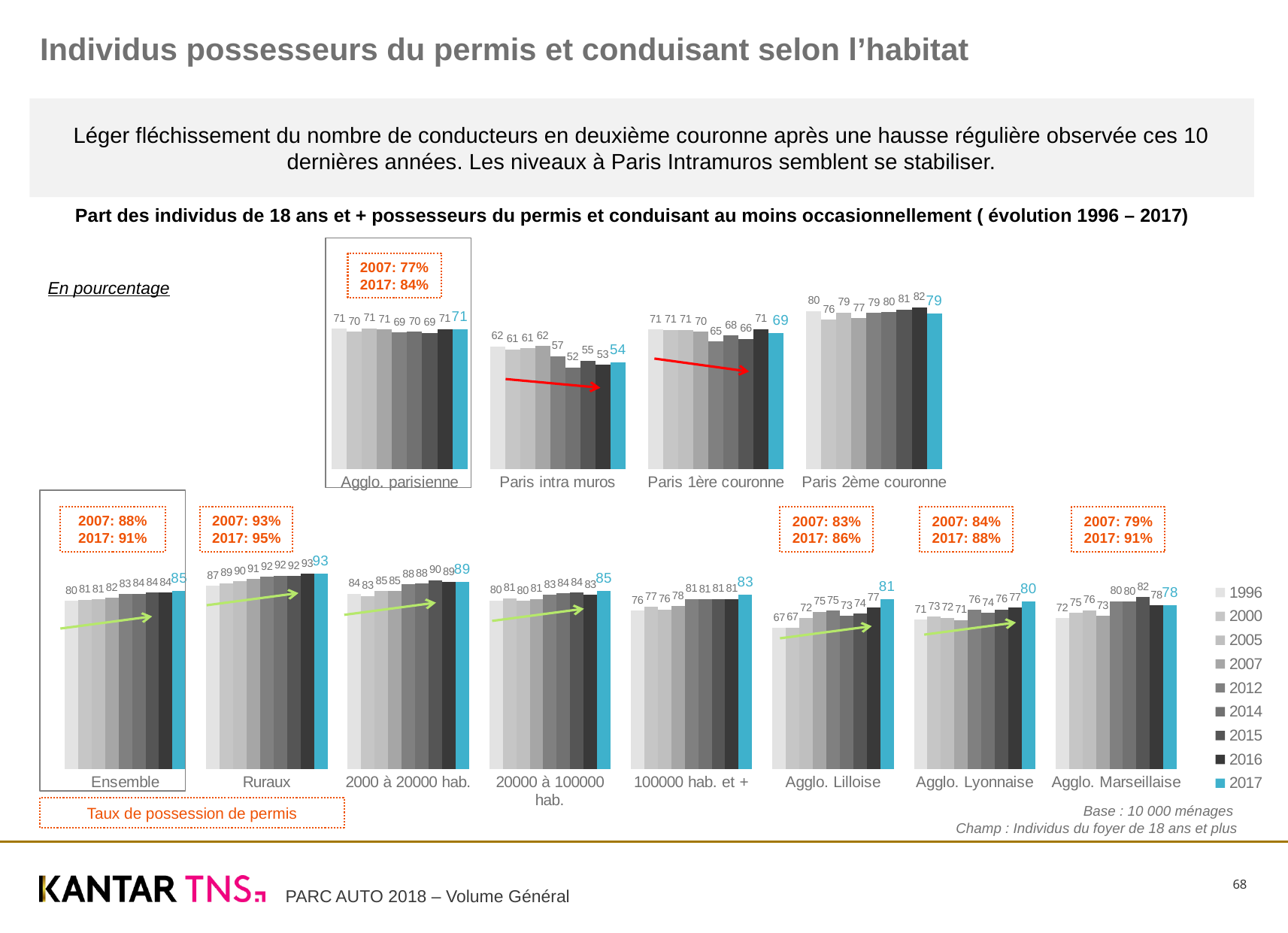
What is the 1996 value for Agglo. Lilloise? 67 What kind of chart is shown on the slide? Bar chart What is the 2017 value for Ruraux? 93 Which category has the highest 2017 value? Ruraux How many series does the legend list? 9 How many habitat categories are shown on the chart? 12 What is the difference between the 2017 and 1996 values for Agglo. Lilloise? 14 Which category has the lowest 2017 value? Paris intra muros What is the 2017 value for Paris intra muros? 54 Which is larger, the 2017 value for Agglo. Lyonnaise or the 2017 value for Agglo. Marseillaise? Agglo. Lyonnaise Which year does the blue bar in the legend represent? 2017 Do the values for Paris intra muros rise or fall from 1996 to 2017? Fall